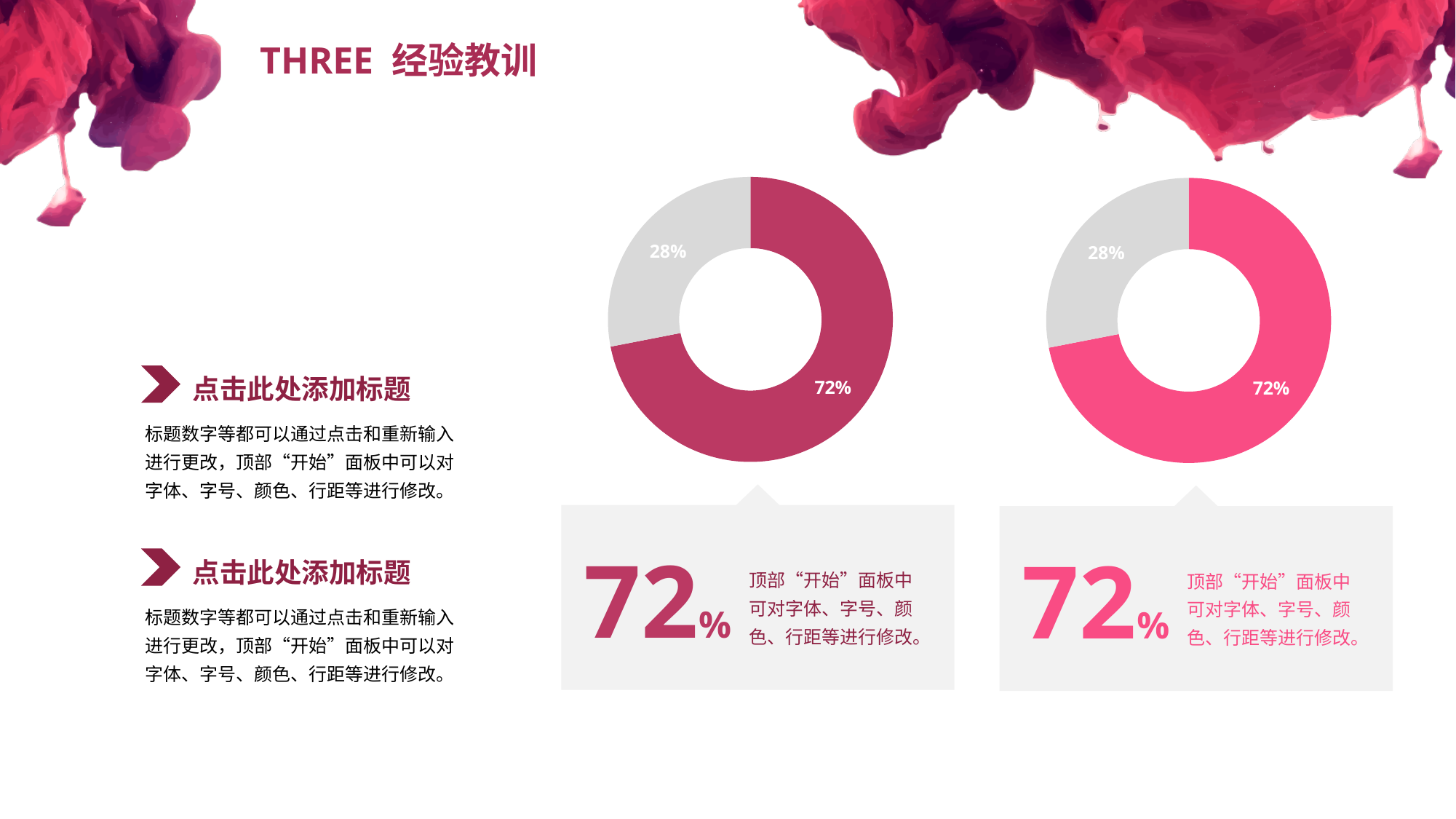
In the left chart, which slice is larger, the dark red slice or the grey slice? the dark red slice What kind of chart is the left chart on the slide? doughnut chart In the left chart, what value is shown on the grey slice? 28% In the right chart, what value is shown on the pink slice? 72% In the right chart, what value is shown on the grey slice? 28% In the right chart, what is the difference between the pink slice and the grey slice? 44% What kind of chart is the right chart on the slide? doughnut chart How many slices does the right chart have? 2 How many slices does the left chart have? 2 How many doughnut charts are shown on the slide? 2 In the left chart, what value is shown on the dark red slice? 72% In the left chart, what is the difference between the 72% slice and the 28% slice? 44%